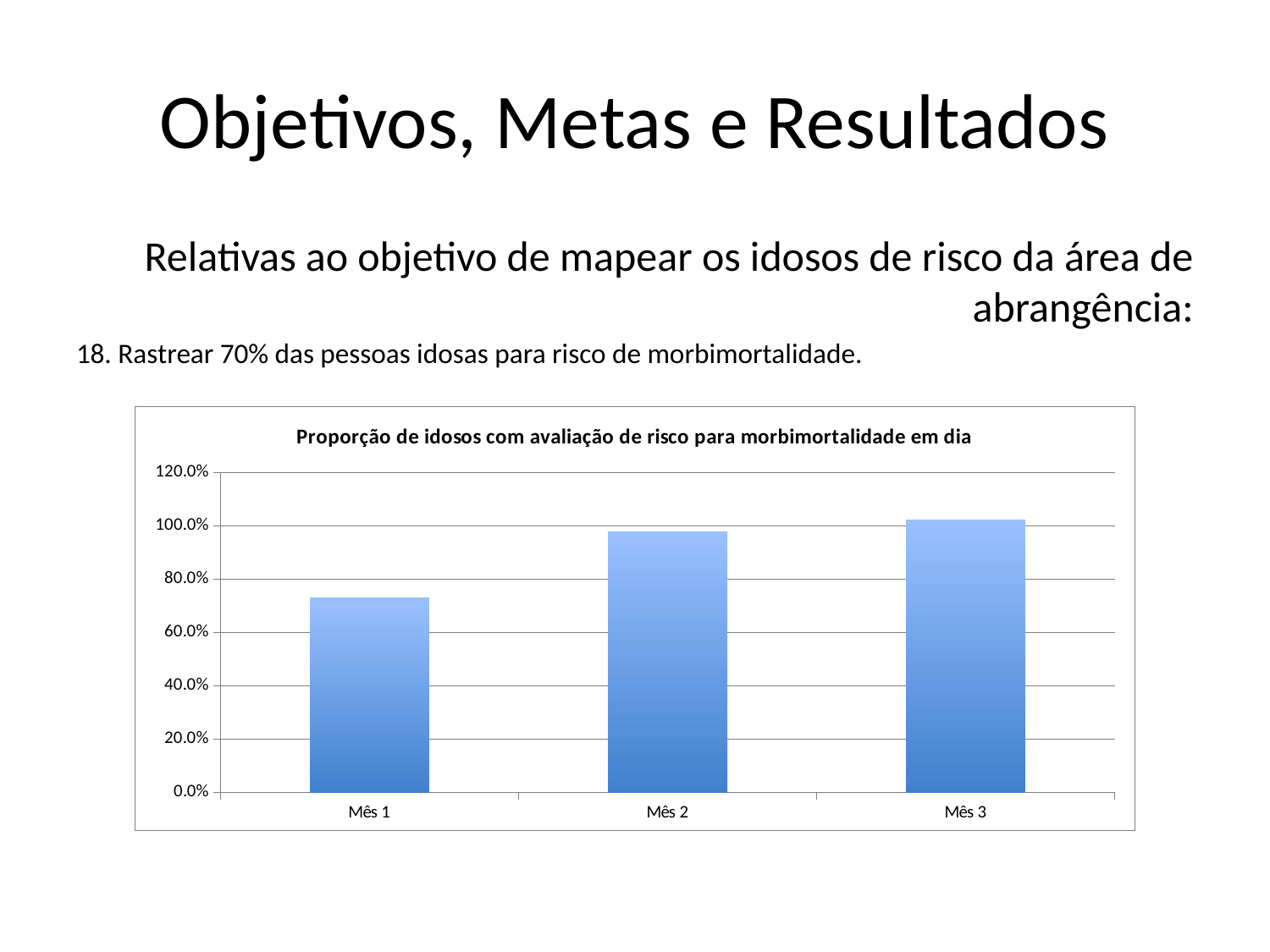
What is the highest value shown on the vertical axis of the chart? 120.0% Which is larger, the value for Mês 1 or the value for Mês 2? Mês 2 Is the value for Mês 1 greater or less than 80.0%? less Do the values rise or fall from Mês 1 to Mês 3? rise Is the value for Mês 1 greater or less than 60.0%? greater What is the title of the chart? Proporção de idosos com avaliação de risco para morbimortalidade em dia Is the value for Mês 3 greater or less than 100.0%? greater Which month has the lowest proportion of elderly with up-to-date risk assessment? Mês 1 How many categories (months) are plotted in the chart? 3 Which month has the highest proportion of elderly with up-to-date risk assessment? Mês 3 What type of chart is shown on the slide? bar chart